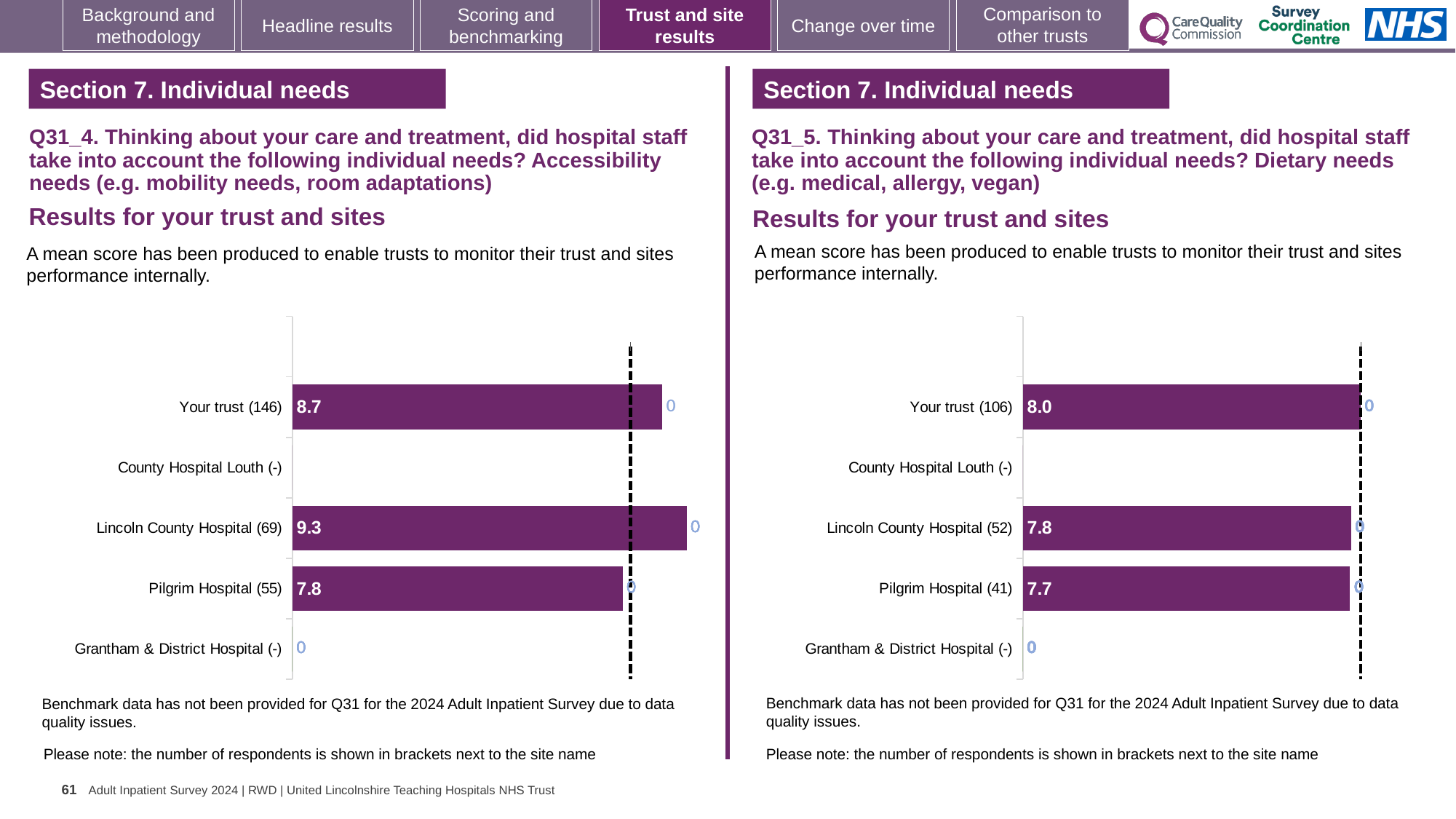
In the left chart (Q31_4, accessibility needs), what is the mean score for Pilgrim Hospital? 7.8 In the left chart (Q31_4, accessibility needs), what is the difference between the mean scores for Lincoln County Hospital and Pilgrim Hospital? 1.5 In the right chart (Q31_5, dietary needs), what is the mean score for Pilgrim Hospital? 7.7 What type of chart is used on the right side of the slide (Q31_5)? Bar chart In the left chart (Q31_4, accessibility needs), what is the mean score for Lincoln County Hospital? 9.3 How many site categories are listed on the y axis of the left chart (Q31_4)? 5 In the left chart (Q31_4, accessibility needs), which site has the highest mean score? Lincoln County Hospital In the left chart (Q31_4, accessibility needs), what is the mean score for Your trust? 8.7 In the right chart (Q31_5, dietary needs), which is larger, the mean score for Your trust or for Pilgrim Hospital? Your trust In the right chart (Q31_5, dietary needs), what is the mean score for Lincoln County Hospital? 7.8 In the right chart (Q31_5, dietary needs), what is the mean score for Your trust? 8.0 In the right chart (Q31_5, dietary needs), what is the difference between the mean scores for Your trust and Lincoln County Hospital? 0.2